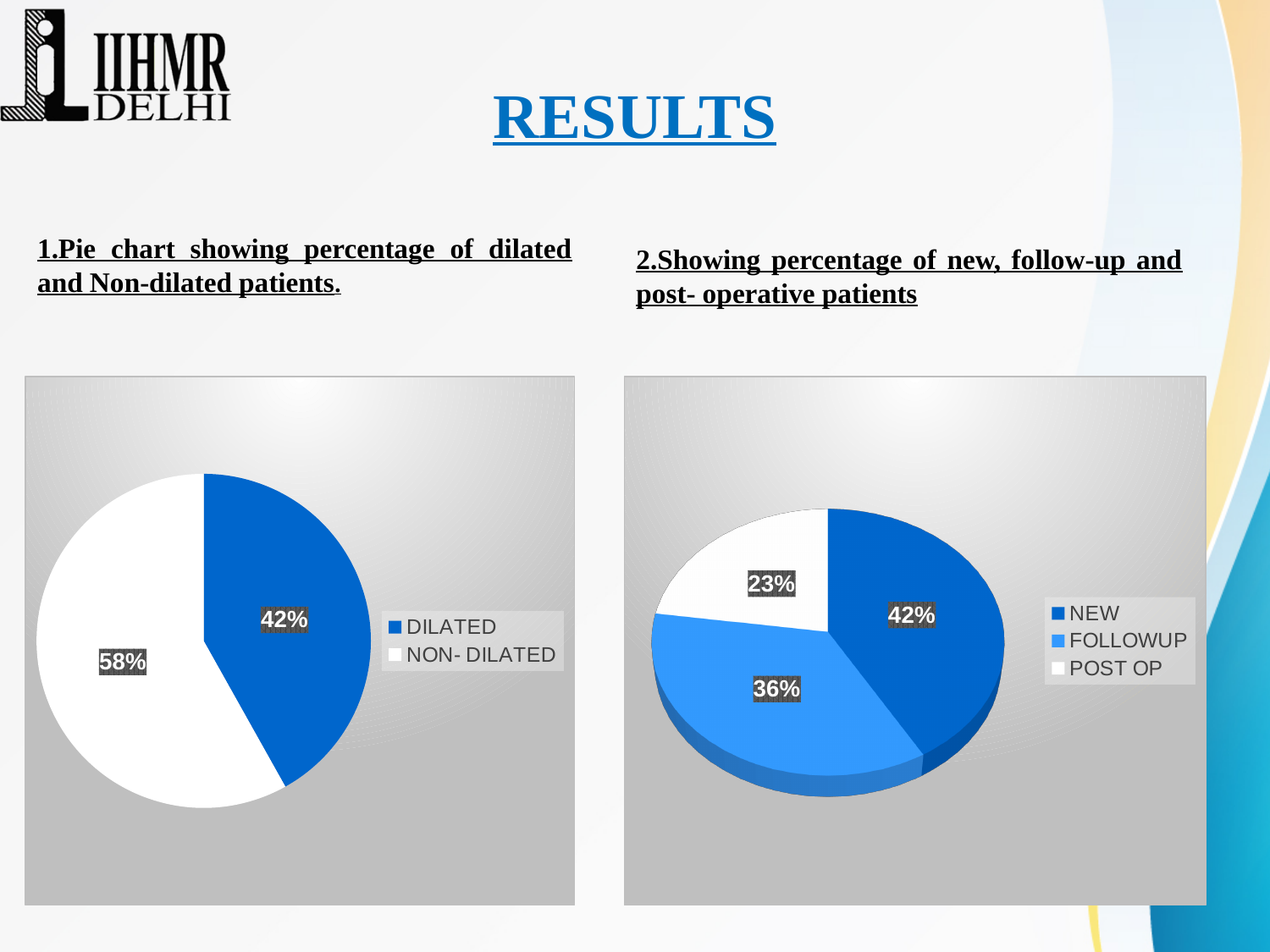
In the right pie chart (new, follow-up and post-operative patients), which is larger, NEW or FOLLOWUP? NEW In the right pie chart (new, follow-up and post-operative patients), what percentage of patients are NEW? 42% In the right pie chart (new, follow-up and post-operative patients), how many categories does the legend list? 3 In the right pie chart (new, follow-up and post-operative patients), what percentage of patients are FOLLOWUP? 36% In the left pie chart (dilated and non-dilated patients), what percentage of patients are DILATED? 42% In the right pie chart (new, follow-up and post-operative patients), what percentage of patients are POST OP? 23% In the left pie chart (dilated and non-dilated patients), what is the difference in percentage points between NON- DILATED and DILATED? 16 In the left pie chart (dilated and non-dilated patients), which category has the larger share? NON- DILATED In the right pie chart (new, follow-up and post-operative patients), which category has the smallest share? POST OP In the left pie chart (dilated and non-dilated patients), how many categories are shown? 2 What type of chart is used on the right side of the slide? Pie chart In the left pie chart (dilated and non-dilated patients), what percentage of patients are NON- DILATED? 58%